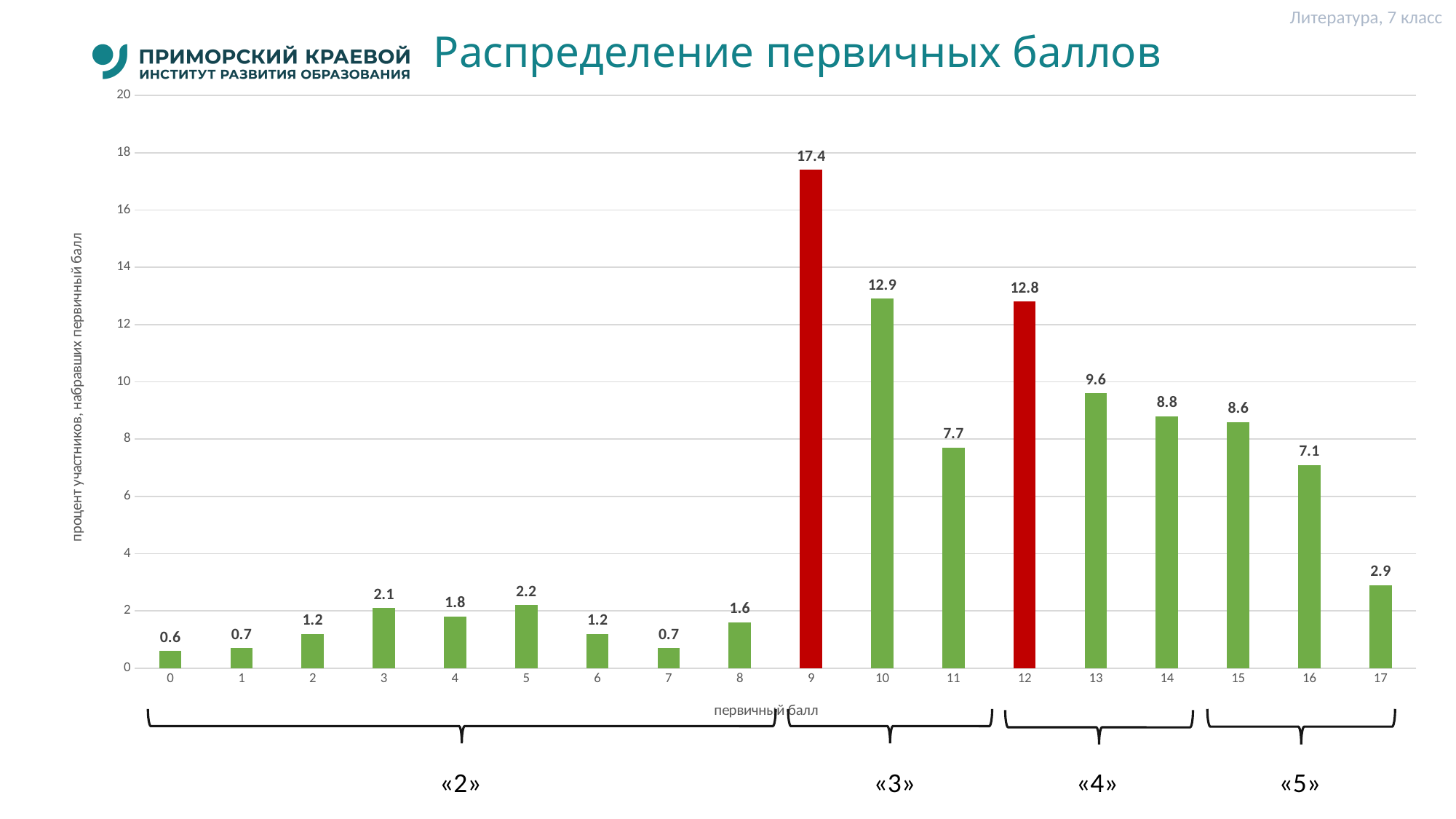
How many primary score categories are shown on the x axis? 18 What is the value for primary score 13? 9.6 What kind of chart is shown on the slide? bar chart Which primary score has the highest percentage of participants? 9 Which primary score has the lowest percentage of participants? 0 What is the difference between the values for primary scores 9 and 10? 4.5 What is the value for primary score 0? 0.6 What is the title of the chart? Распределение первичных баллов Which primary scores are shown with red bars? 9 and 12 What is the value for primary score 9? 17.4 Is the value for primary score 11 greater or less than 8? less Which is larger, the value for primary score 12 or for primary score 13? 12